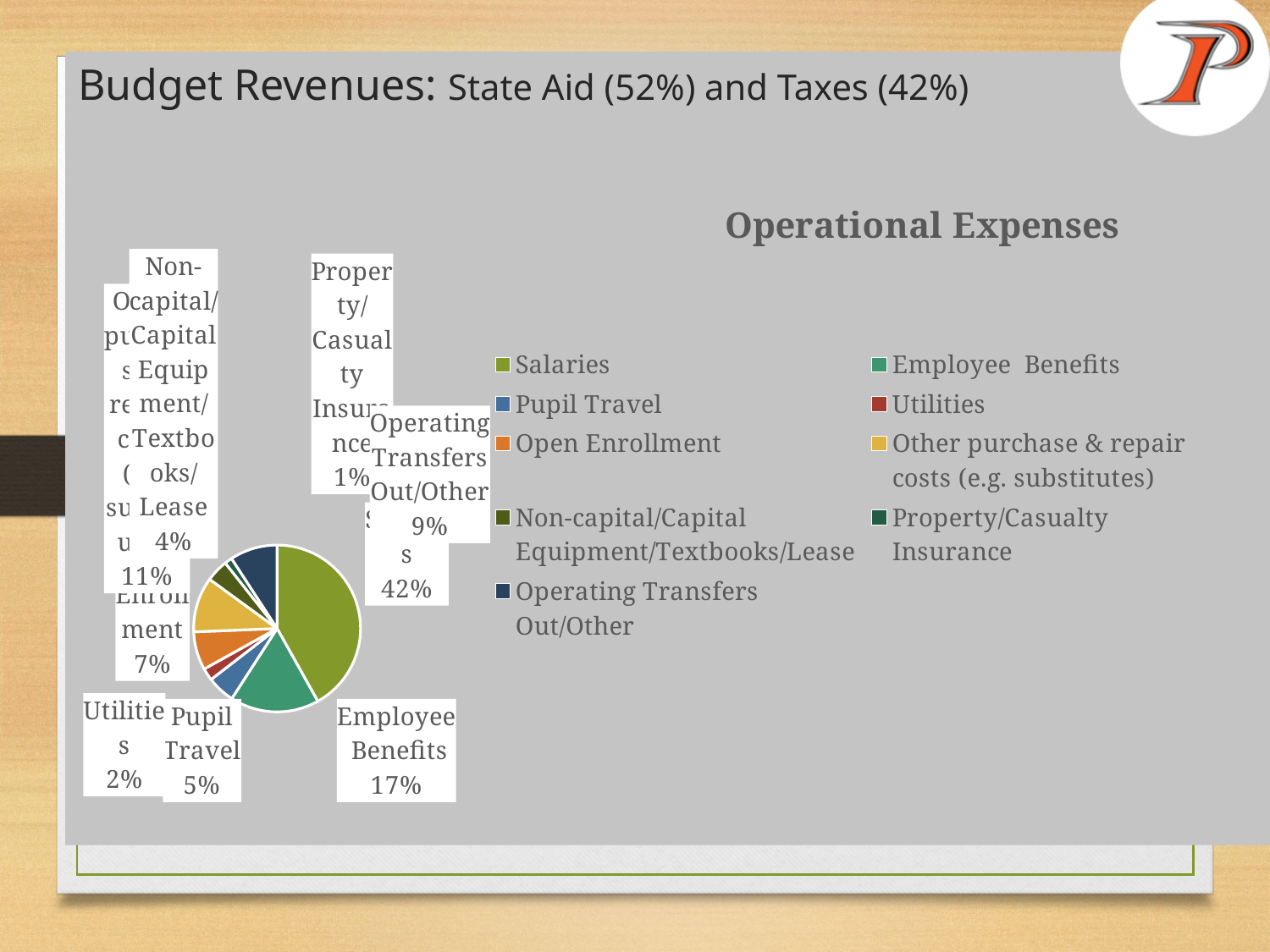
What share of operational expenses is Pupil Travel? 5% What share of operational expenses is Employee Benefits? 17% Which category has the smallest slice of the pie? Property/Casualty Insurance What share of operational expenses is Utilities? 2% What share of operational expenses is Salaries? 42% What share of operational expenses is Operating Transfers Out/Other? 9% Which category has the largest slice of the pie? Salaries How many percentage points larger is Salaries than Employee Benefits? 25 What is the title of the chart? Operational Expenses What share of operational expenses is Property/Casualty Insurance? 1% What kind of chart is shown on the slide? pie chart How many categories does the legend list? 9